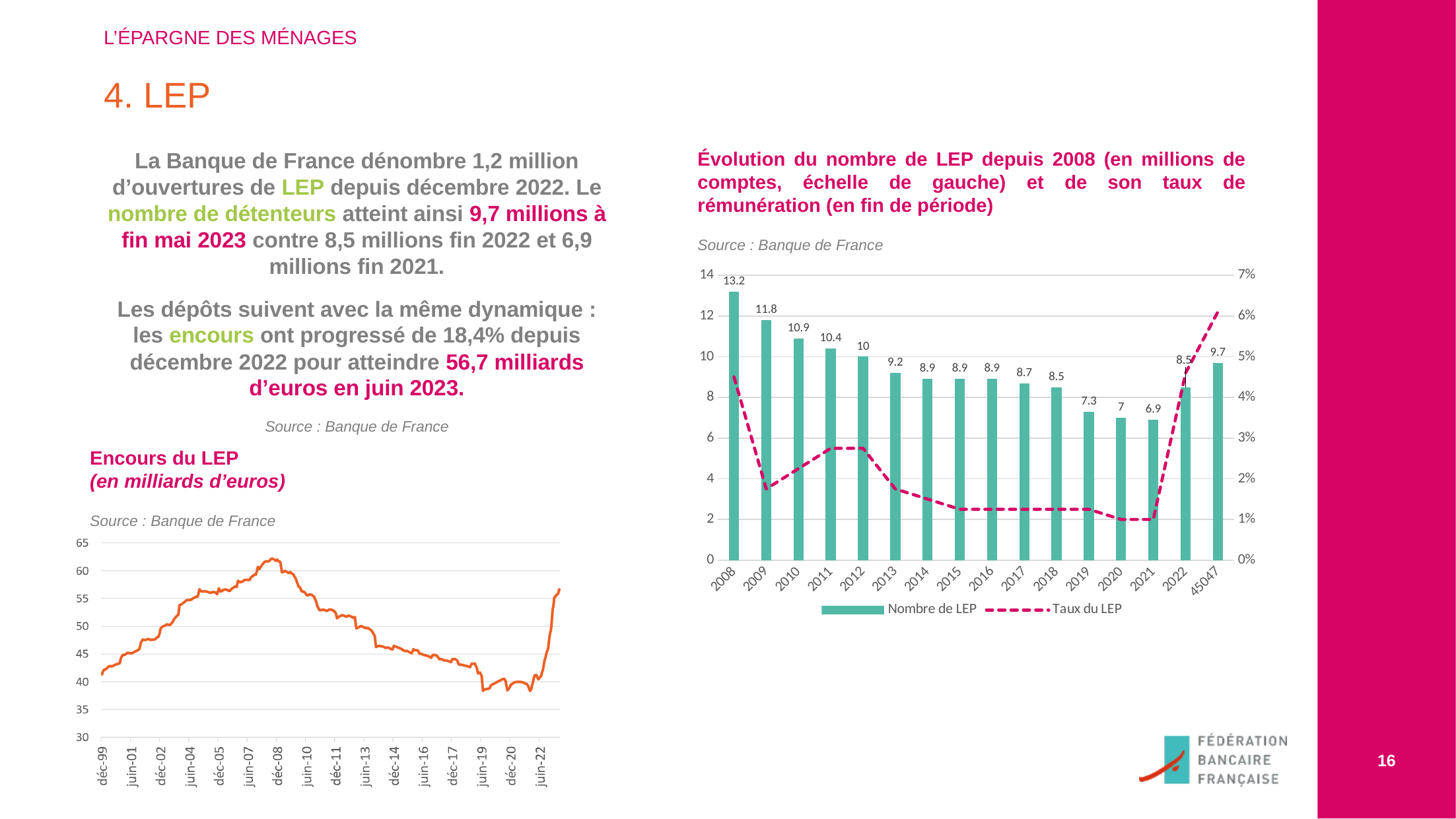
In the chart titled 'Évolution du nombre de LEP depuis 2008', what is the difference between the 'Nombre de LEP' values for 2022 and 2021? 1.6 In the chart titled 'Évolution du nombre de LEP depuis 2008', how many bars are plotted? 16 In the chart titled 'Évolution du nombre de LEP depuis 2008', what is the value of 'Nombre de LEP' for 2021? 6.9 In the 'Encours du LEP (en milliards d'euros)' chart, is the value at déc-08 greater or less than 60? greater In the chart titled 'Évolution du nombre de LEP depuis 2008', which year has the lowest 'Nombre de LEP' bar? 2021 In the chart titled 'Évolution du nombre de LEP depuis 2008', is the 'Nombre de LEP' bar for 2010 larger or smaller than the bar for 2019? larger In the chart titled 'Évolution du nombre de LEP depuis 2008', which year has the highest 'Nombre de LEP' bar? 2008 In the 'Encours du LEP (en milliards d'euros)' chart, is the value at déc-99 greater or less than 45? less In the chart titled 'Évolution du nombre de LEP depuis 2008', what is the value of 'Nombre de LEP' for 2008? 13.2 In the chart titled 'Évolution du nombre de LEP depuis 2008', how many series does the legend list? 2 In the chart titled 'Évolution du nombre de LEP depuis 2008', is the 'Taux du LEP' value for 2020 greater or less than 2%? less What kind of chart is the 'Encours du LEP (en milliards d'euros)' chart on the left of the slide? line chart